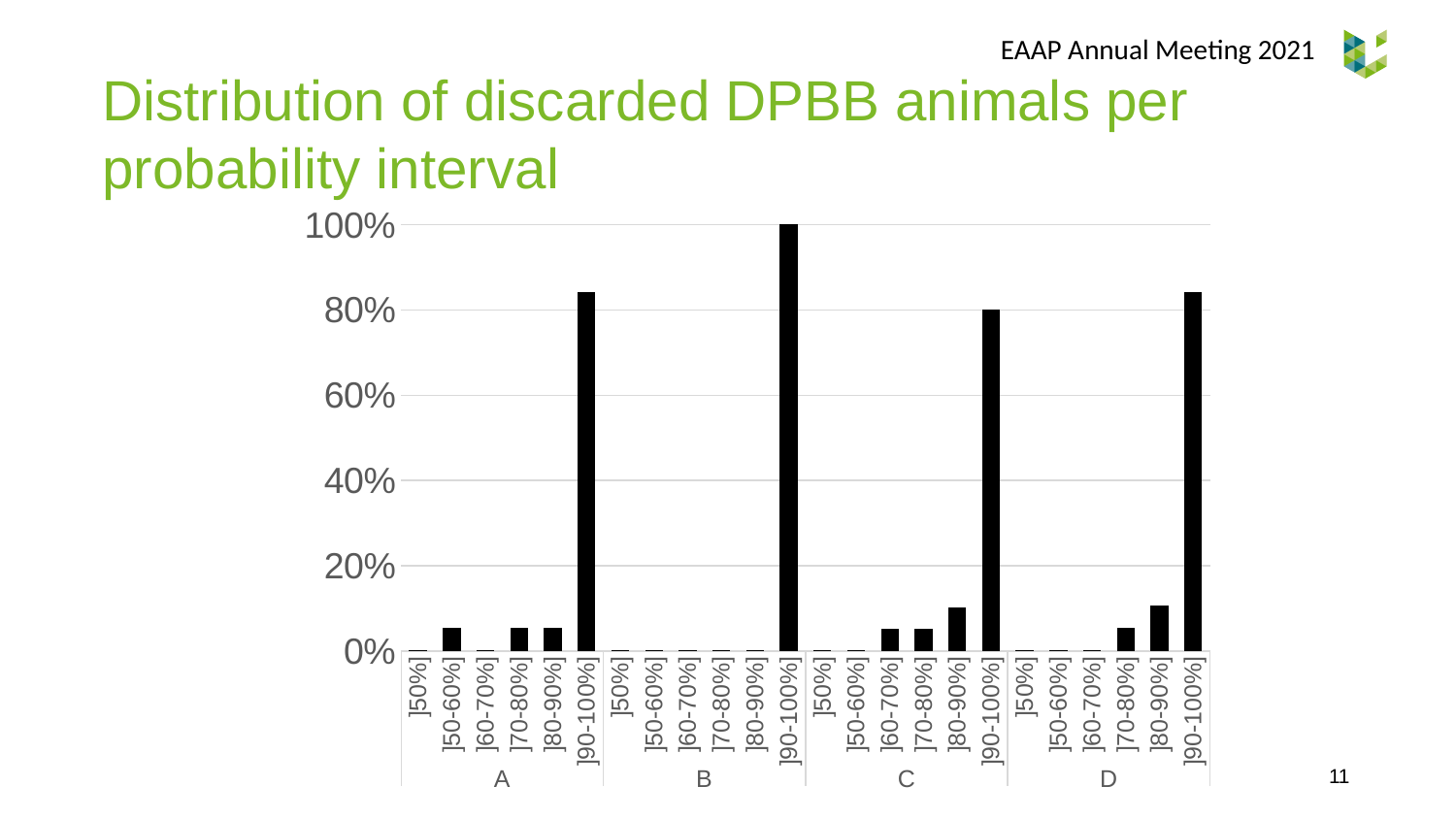
How many probability intervals are shown within each group? 6 What is the value for the ]90-100%] interval in group B? 100% Which is larger: the ]90-100%] value in group B or the ]90-100%] value in group C? group B What kind of chart is shown on the slide? bar chart What is the value for the ]90-100%] interval in group C? 80% Which probability interval has the highest value in group A? ]90-100%] What is the highest value shown on the vertical axis? 100% What is the title of the chart? Distribution of discarded DPBB animals per probability interval Which group has the highest value for the ]90-100%] interval? B How many groups (A, B, C, D) are shown along the x axis? 4 Is the value for the ]90-100%] interval in group A greater or less than 80%? greater Is the value for the ]80-90%] interval in group D greater or less than 20%? less